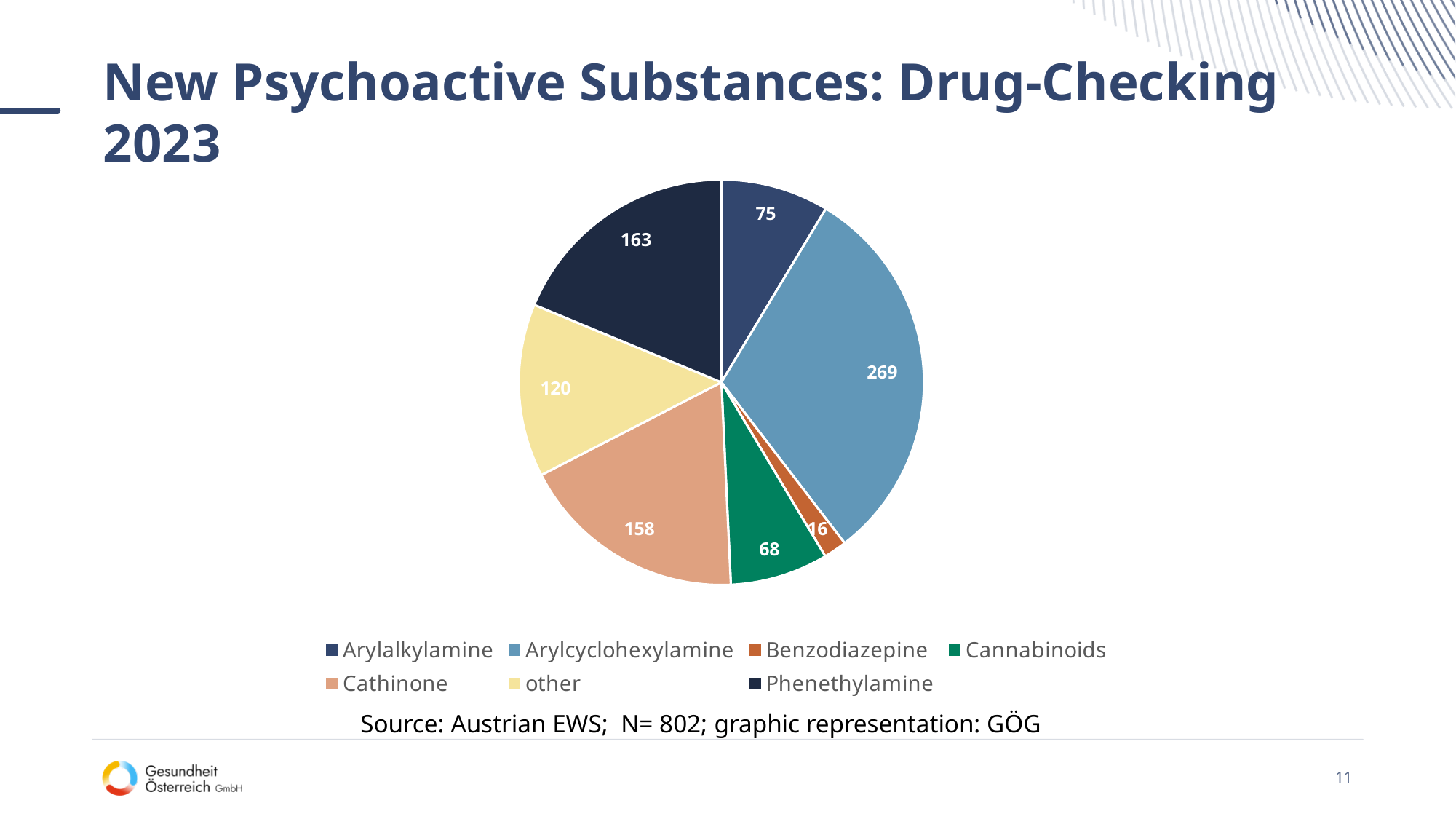
How many categories does the pie chart show? 7 Which category has the smallest slice? Benzodiazepine What is the difference between the values for Arylcyclohexylamine and Cathinone? 111 What is the value for Cathinone? 158 What is the value for Phenethylamine? 163 What type of chart is shown on the slide? pie chart What is the value for Arylcyclohexylamine? 269 Which is larger, the value for Cannabinoids or the value for Arylalkylamine? Arylalkylamine What is the value for Benzodiazepine? 16 What is the title of the slide containing the chart? New Psychoactive Substances: Drug-Checking 2023 What is the difference between the values for other and Arylalkylamine? 45 Which category has the largest slice? Arylcyclohexylamine